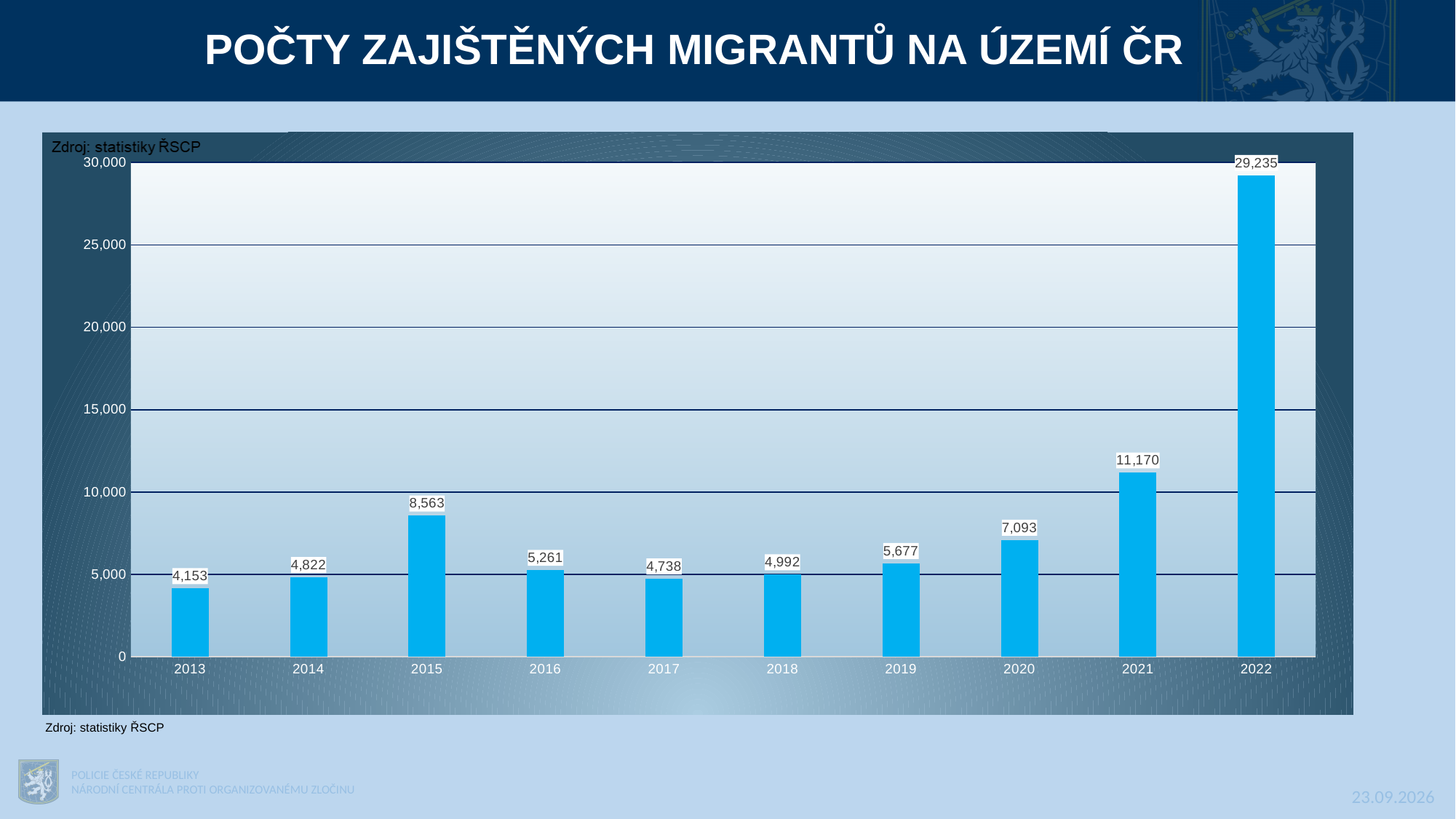
What is the value for 2017? 4,738 What is the value for 2015? 8,563 Which year has the highest value? 2022 Is the value for 2021 greater or less than 10,000? greater What is the value for 2021? 11,170 How many years are shown on the x axis? 10 What kind of chart is shown on the slide? bar chart Which year has the lowest value? 2013 What is the difference between the values for 2022 and 2021? 18,065 What is the difference between the values for 2020 and 2019? 1,416 Which is larger, the value for 2016 or the value for 2018? 2016 What is the title of the slide? POČTY ZAJIŠTĚNÝCH MIGRANTŮ NA ÚZEMÍ ČR